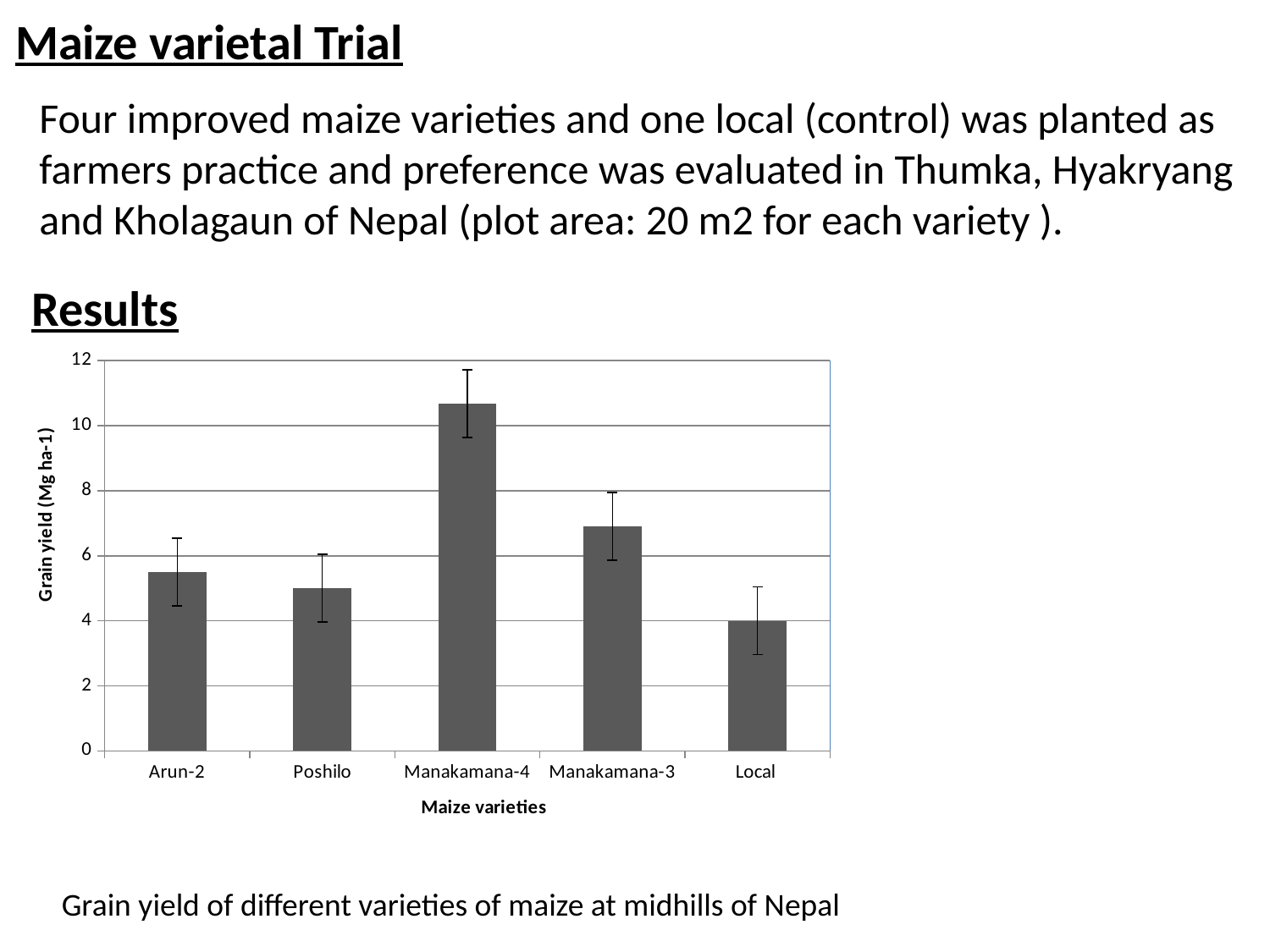
How many maize varieties are plotted on the chart? 5 Which maize variety has the highest grain yield? Manakamana-4 Is the grain yield for Manakamana-3 greater or less than 6? greater Which has the higher grain yield, Manakamana-3 or Arun-2? Manakamana-3 What is the label of the horizontal axis of the chart? Maize varieties Is the grain yield for Arun-2 greater or less than 6? less What kind of chart is shown on the slide? bar chart What is the label of the vertical axis of the chart? Grain yield (Mg ha-1) Which maize variety has the lowest grain yield? Local Is the grain yield for Manakamana-4 greater or less than 10? greater Which has the higher grain yield, Manakamana-4 or Manakamana-3? Manakamana-4